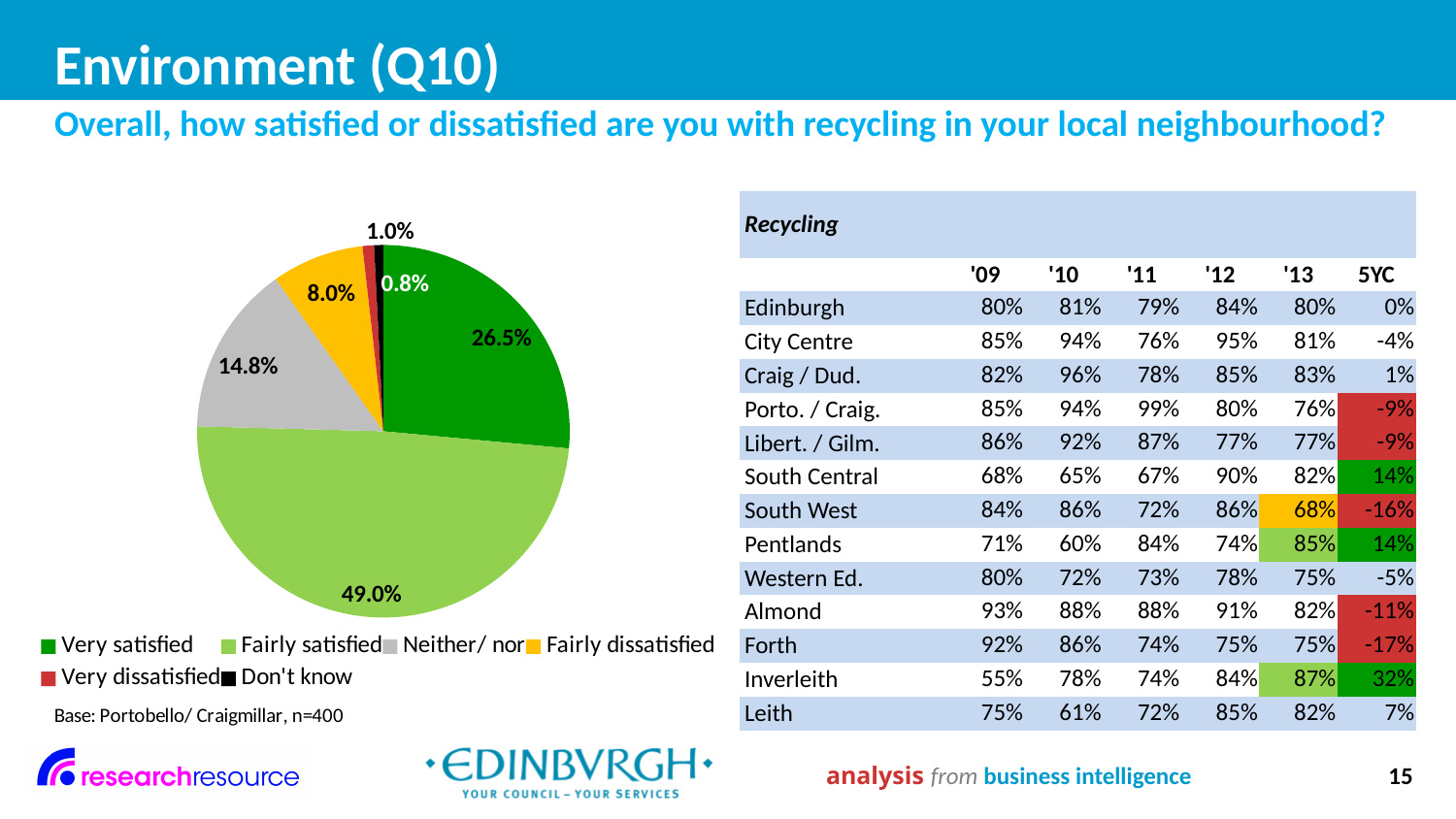
Which category has the smallest slice of the pie chart? Don't know What share of the pie is 'Neither/ nor'? 14.8% How many categories does the pie chart legend list? 6 What type of chart is shown on the slide? Pie chart What is the combined percentage of 'Very satisfied' and 'Fairly satisfied' respondents? 75.5% What percentage of respondents are fairly dissatisfied? 8.0% What percentage of respondents are very satisfied with recycling? 26.5% What percentage of respondents answered 'Don't know'? 0.8% What is the difference between the 'Fairly satisfied' and 'Very satisfied' percentages? 22.5% What percentage of respondents are fairly satisfied with recycling in their local neighbourhood? 49.0% Which is larger: the 'Neither/ nor' slice or the 'Fairly dissatisfied' slice? Neither/ nor Which category has the largest slice of the pie chart? Fairly satisfied